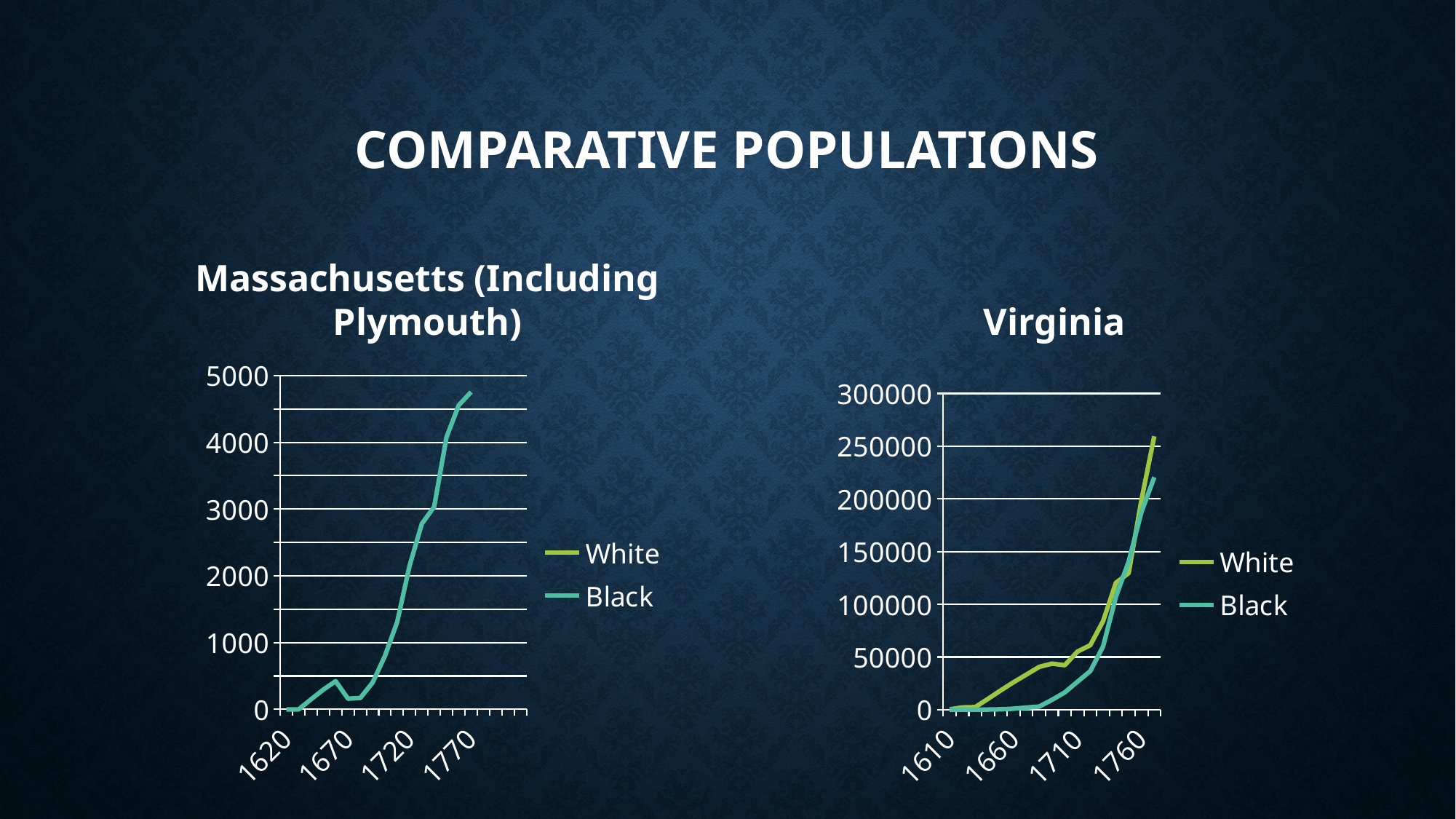
In the Virginia chart, which series is larger at 1710, White or Black? White What kind of chart is the Massachusetts (Including Plymouth) chart? line chart How many series does the legend of the Massachusetts (Including Plymouth) chart list? 2 What kind of chart is the Virginia chart? line chart In the Virginia chart, which series reaches the highest value? White In the Virginia chart, is the Black value at 1710 greater or less than 50000? less In the Massachusetts (Including Plymouth) chart, does the Black population rise or fall overall from 1620 to 1770? rise In the Virginia chart, does the White population rise or fall over time along the x axis? rise How many series does the legend of the Virginia chart list? 2 In the Virginia chart, is the White value at 1710 greater or less than 50000? greater In the Massachusetts (Including Plymouth) chart, is the Black value at 1770 greater or less than 3000? greater What is the title of the chart on the right side of the slide? Virginia